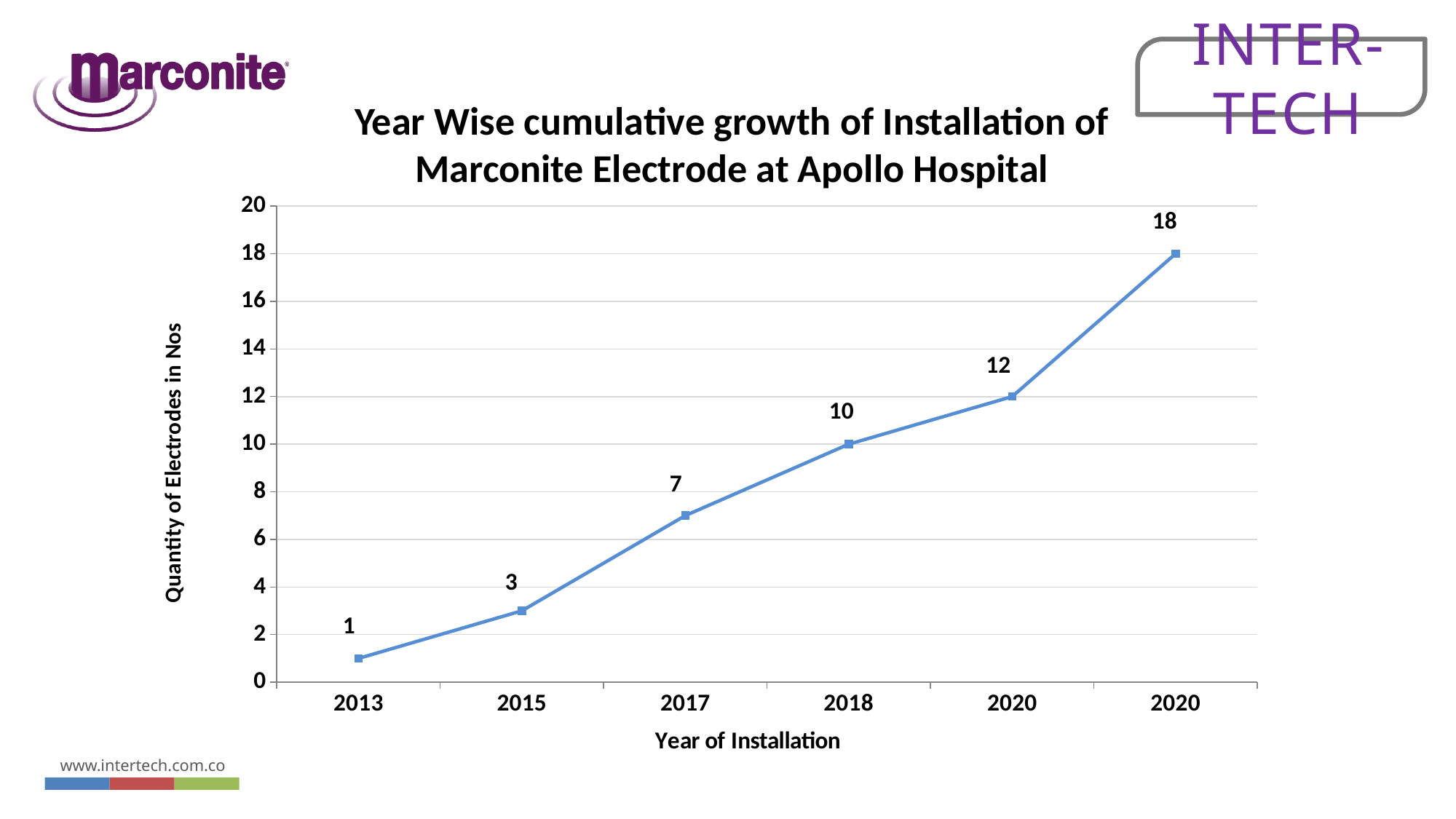
Which year has the lowest value? 2013 What is the value for 2013? 1 What is the highest value plotted on the chart? 18 How many data points are plotted on the line? 6 What is the value of the last (rightmost) point on the line? 18 What is the difference between the values for 2018 and 2017? 3 What is the value for 2017? 7 What is the value for 2015? 3 Do the values rise or fall from left to right along the x axis? Rise What is the value for 2018? 10 Which is larger, the value for 2015 or the value for 2017? 2017 What kind of chart is shown? Line chart